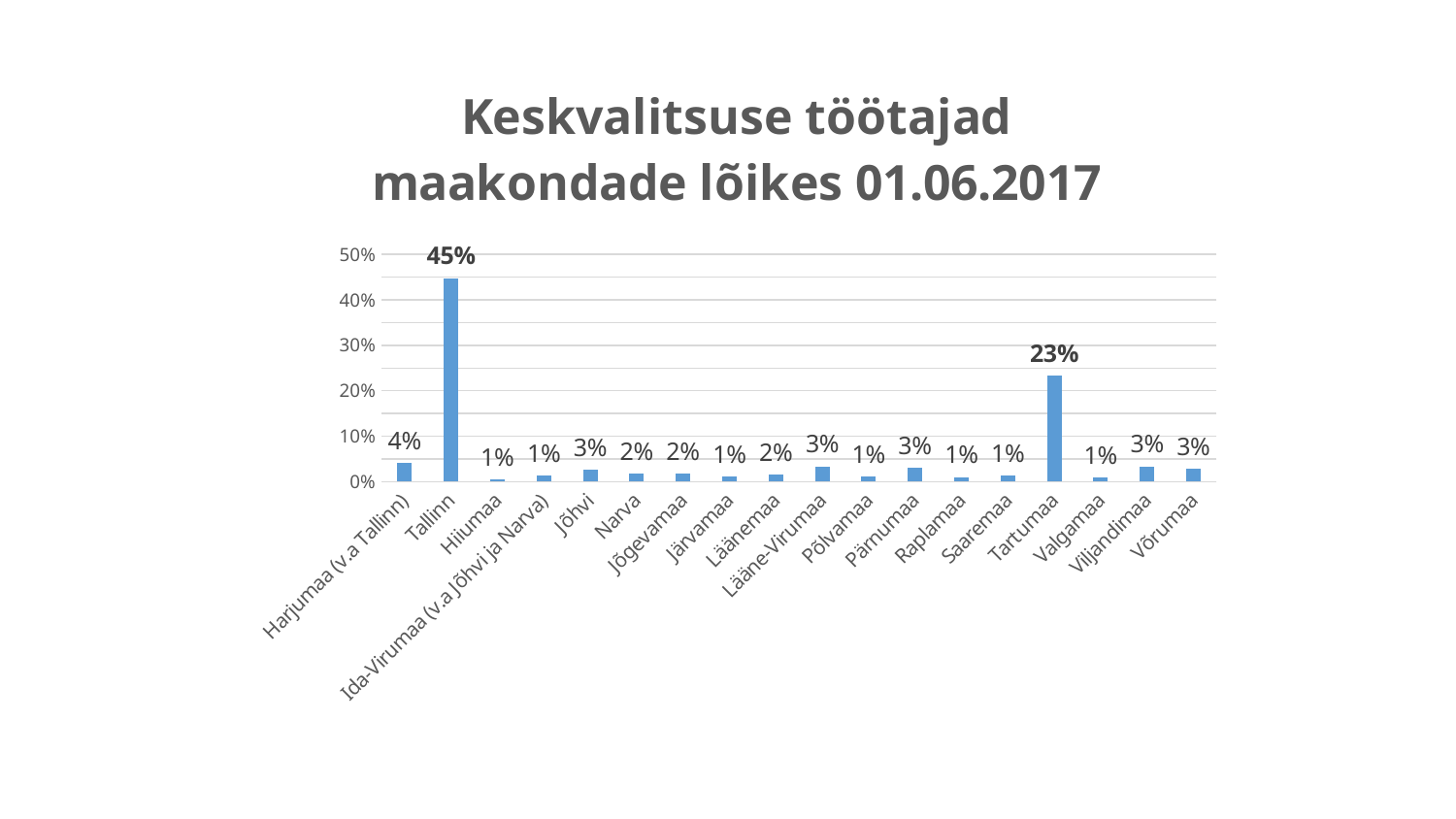
What is the value for Tartumaa? 23% How many categories are shown on the x axis? 18 What is the value for Tallinn? 45% What is the value for Harjumaa (v.a Tallinn)? 4% What is the value for Narva? 2% What is the value for Pärnumaa? 3% Which category has the highest value? Tallinn Is the value for Tallinn greater or less than 40%? greater What is the difference between the values for Tallinn and Tartumaa? 22 percentage points What is the title of the chart? Keskvalitsuse töötajad maakondade lõikes 01.06.2017 Which is larger, the value for Tartumaa or the value for Harjumaa (v.a Tallinn)? Tartumaa What kind of chart is shown on the slide? bar chart